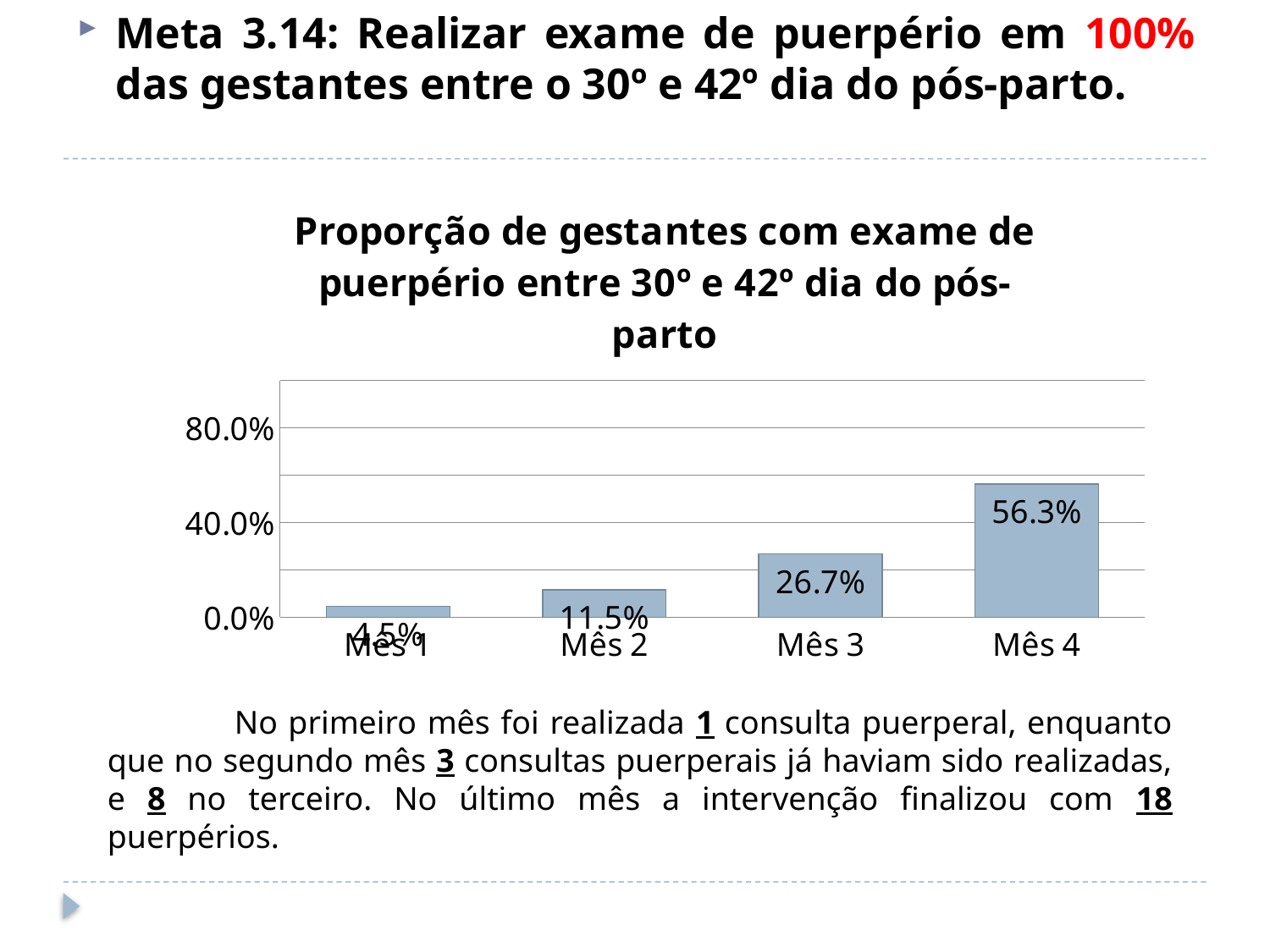
What is the value for Mês 4? 56.3% What is the value for Mês 3? 26.7% What kind of chart is shown on the slide? bar chart Which month has the highest proportion? Mês 4 Is the value for Mês 4 greater or less than 40.0%? greater Do the values rise or fall from Mês 1 to Mês 4? rise Which month has the lowest proportion? Mês 1 What is the difference between the values for Mês 3 and Mês 2? 15.2% Which is larger, the value for Mês 2 or the value for Mês 3? Mês 3 What is the value for Mês 2? 11.5% How many months are shown on the x axis? 4 What is the difference between the values for Mês 4 and Mês 3? 29.6%